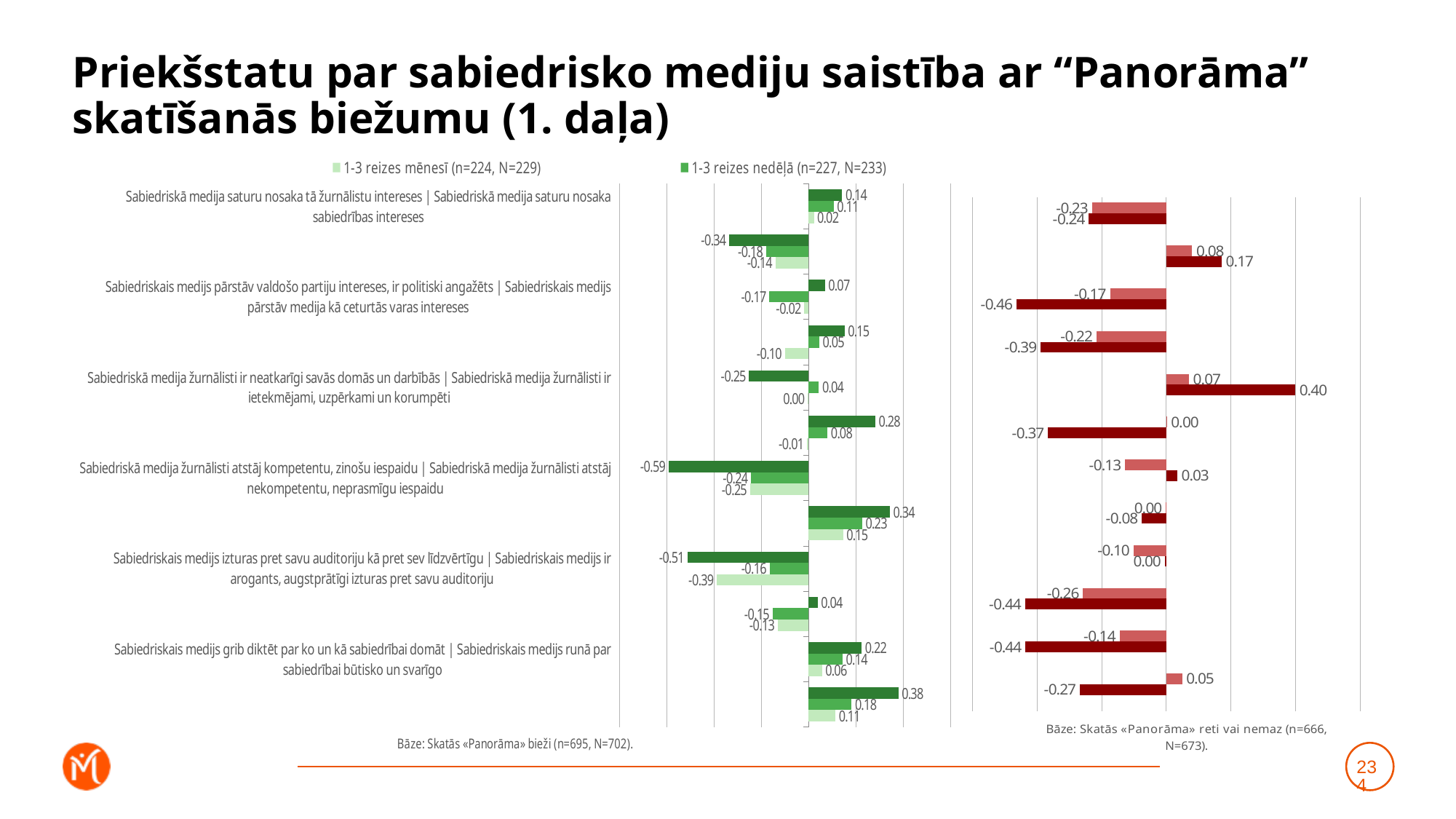
In the right (red) chart, what is the highest value labelled on any bar? 0.40 In the left (green) chart, what is the highest value labelled on any bar? 0.38 What kind of chart is shown on the left side of the slide? bar chart How many category labels are listed down the left side of the charts? 6 How many series does the legend above the left chart list? 2 In the right (red) chart, what is the lowest value labelled on any bar? -0.46 What is the first legend entry shown above the left chart? 1-3 reizes mēnesī (n=224, N=229) What is the difference between the highest value in the right (red) chart (0.40) and the highest value in the left (green) chart (0.38)? 0.02 Which chart contains the larger maximum value, the left (green) chart with 0.38 or the right (red) chart with 0.40? the right (red) chart In the left (green) chart, what is the lowest value labelled on any bar? -0.59 What base note is printed below the left (green) chart? Bāze: Skatās «Panorāma» bieži (n=695, N=702).